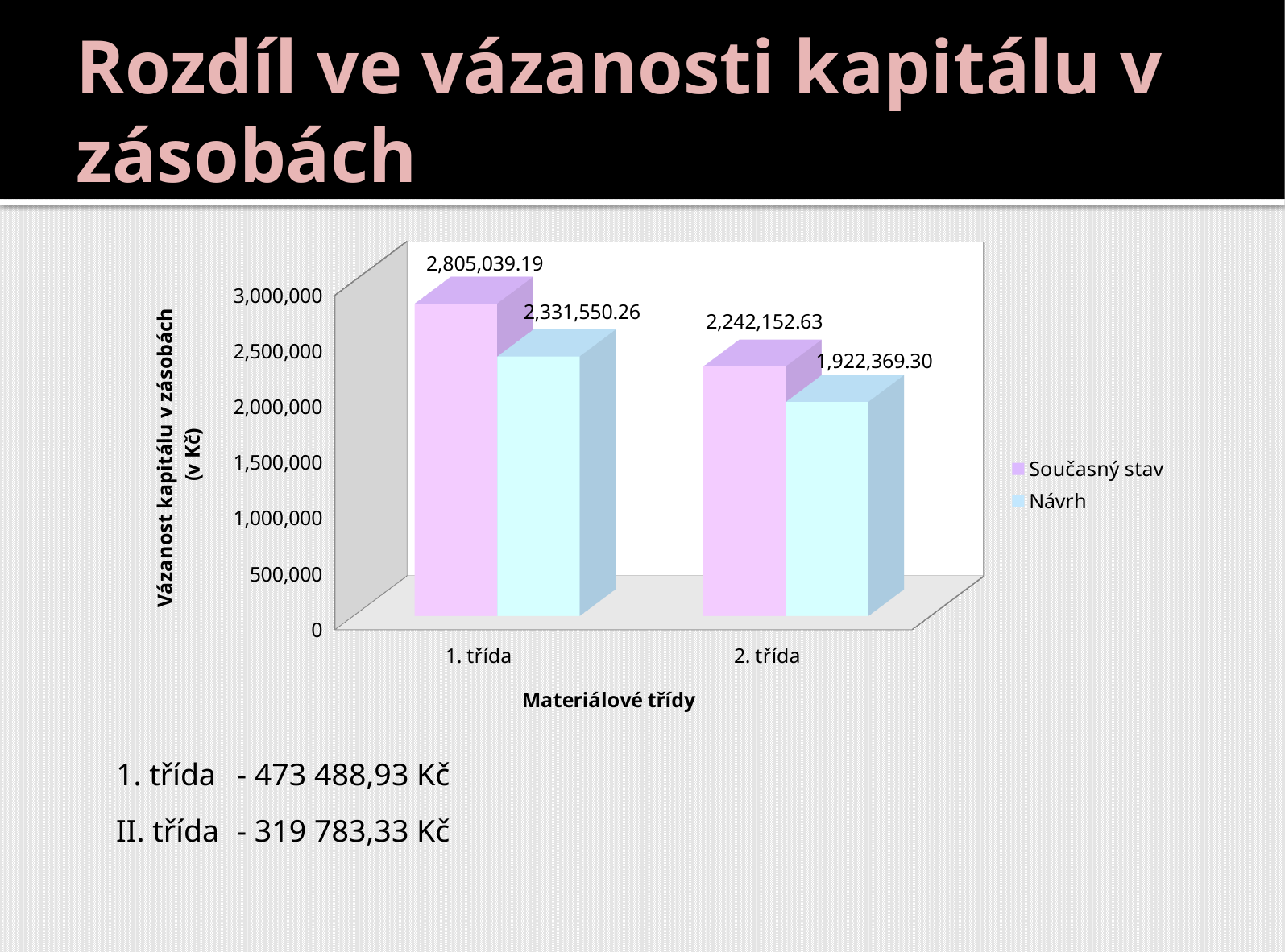
Is the Návrh value for 2. třída greater or less than 2,000,000? less What is the value of Současný stav for 1. třída? 2,805,039.19 Which is larger for 2. třída, Současný stav or Návrh? Současný stav Which category has the highest Současný stav value? 1. třída What is the value of Návrh for 2. třída? 1,922,369.30 What is the value of Současný stav for 2. třída? 2,242,152.63 What is the difference between Současný stav and Návrh for 1. třída? 473,488.93 What is the difference between Současný stav and Návrh for 2. třída? 319,783.33 How many series does the legend list? 2 What kind of chart is shown on the slide? bar chart What is the value of Návrh for 1. třída? 2,331,550.26 Which category has the lowest Návrh value? 2. třída